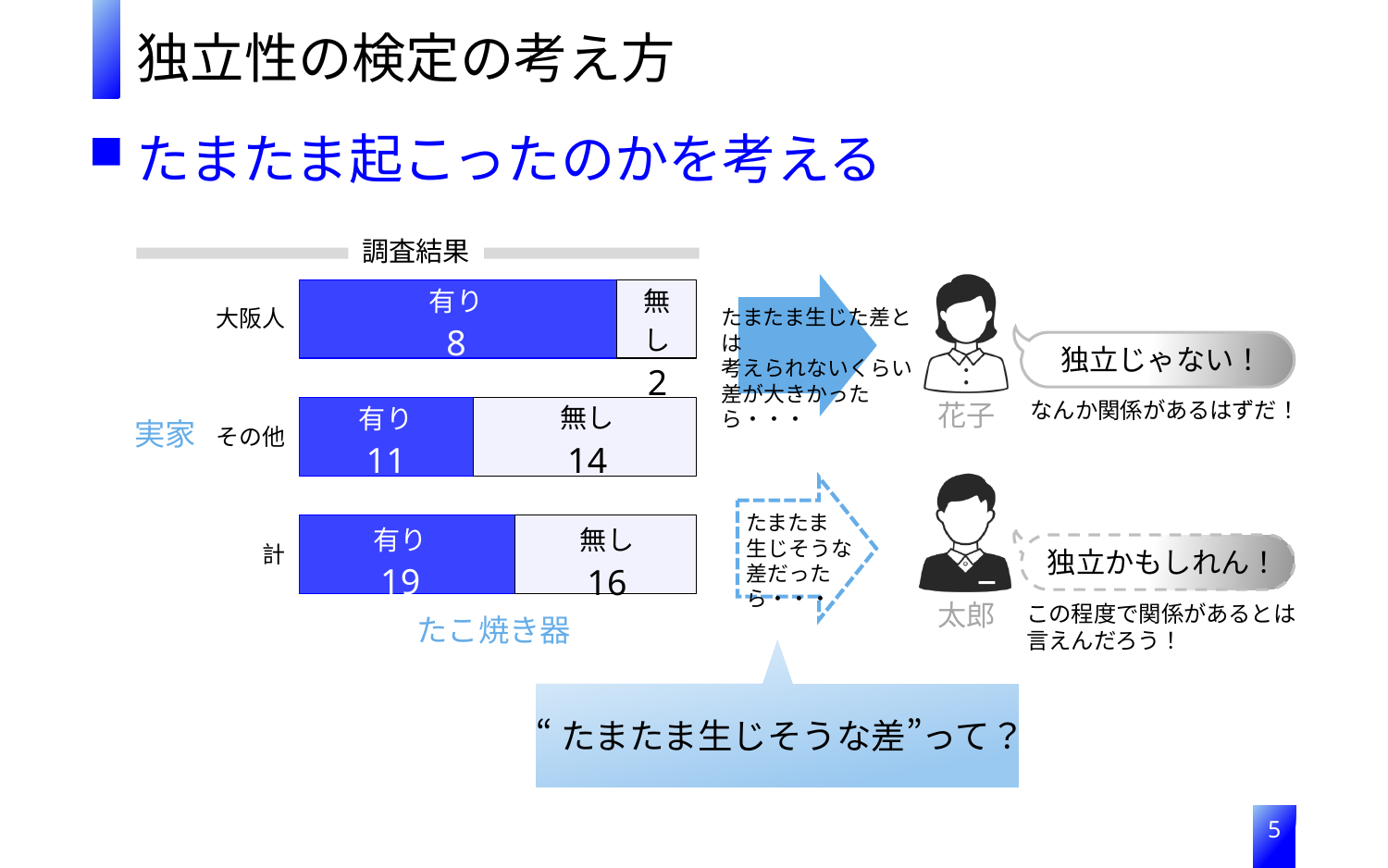
What kind of chart is the 調査結果 chart? Stacked bar chart In the 調査結果 chart, which row has the highest 有り value? 計 In the 調査結果 chart, what is the total of the その他 bar? 25 In the 調査結果 chart, what is the value of 有り for 計? 19 In the 調査結果 chart, which is larger for 大阪人: 有り or 無し? 有り In the 調査結果 chart, what is the value of 無し for その他? 14 In the 調査結果 chart, what is the total of the 大阪人 bar? 10 In the 調査結果 chart, which row has the lowest 無し value? 大阪人 How many rows (categories) does the 調査結果 chart show? 3 In the 調査結果 chart, what is the value of 無し for 大阪人? 2 In the 調査結果 chart, what is the value of 有り for 大阪人? 8 In the 調査結果 chart, what is the difference between 無し and 有り for その他? 3